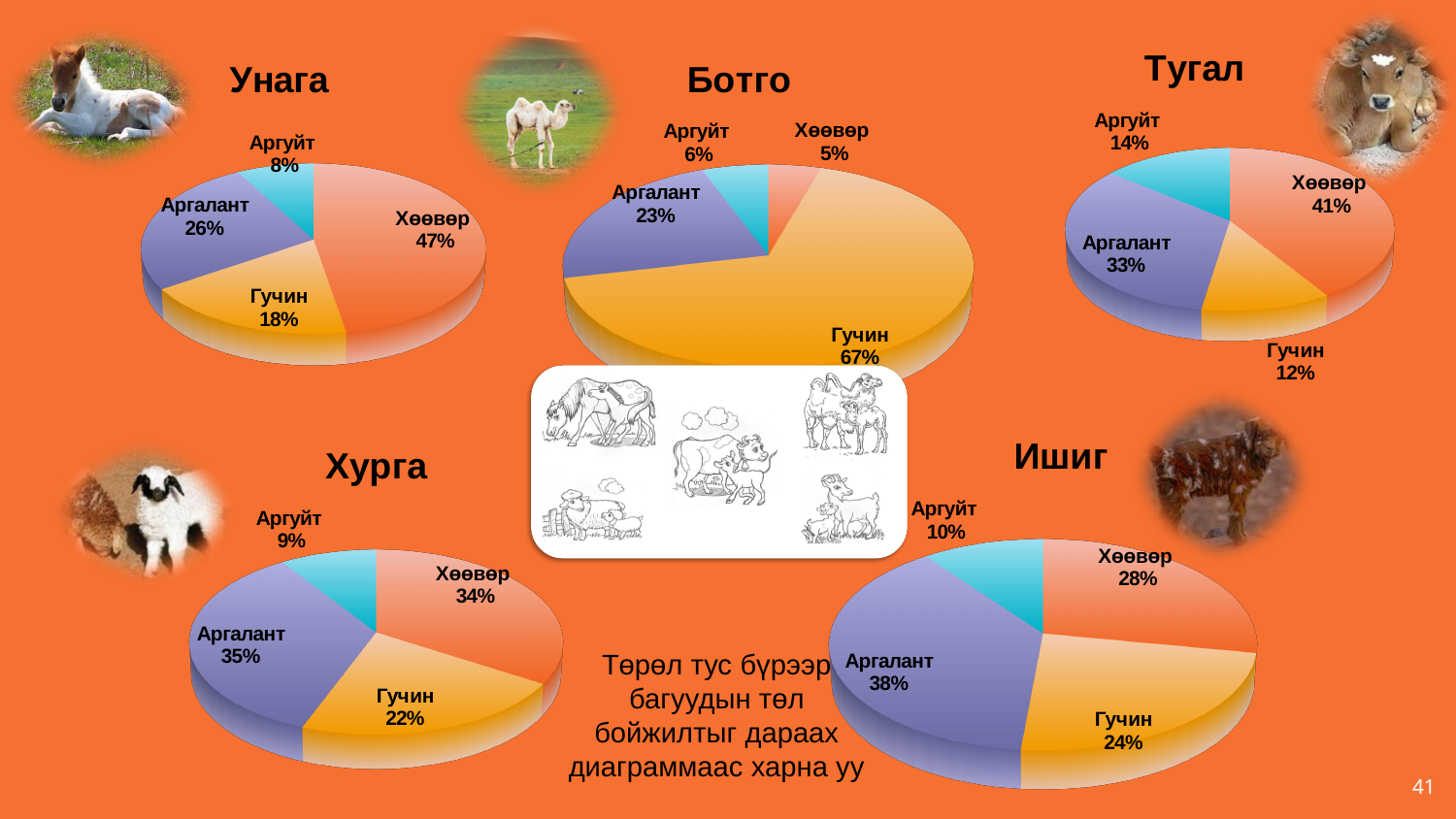
In the Тугал pie chart, what is the share for Аргалант? 33% How many pie charts are shown on the slide? 5 In the Унага pie chart, what share does Хөөвөр have? 47% In the Ботго pie chart, which category has the smallest slice? Хөөвөр In the Ботго pie chart, which category has the largest slice? Гучин In the Хурга pie chart, which is larger, Аргалант or Хөөвөр? Аргалант How many slices does the Унага pie chart have? 4 In the Хурга pie chart, what share does Гучин have? 22% What type of chart is used for Ботго? Pie chart In the Тугал pie chart, what is the difference between the Хөөвөр and Гучин shares? 29% In the Ишиг pie chart, what is the share for Аргуйт? 10% In the Ишиг pie chart, which category has the largest share? Аргалант